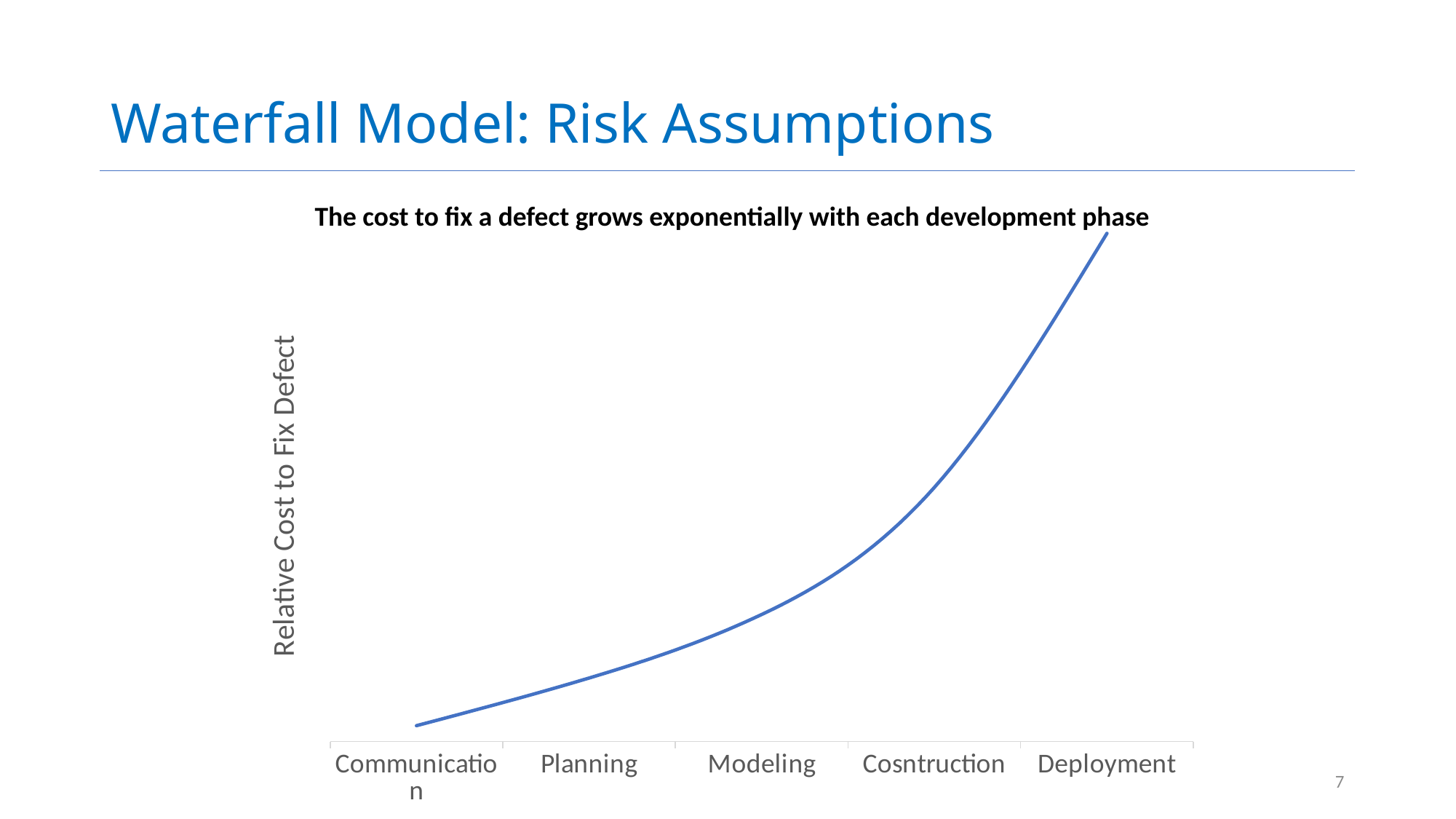
Which phase has a lower relative cost to fix a defect, Planning or Construction? Planning Which phase appears immediately after Modeling on the x axis? Cosntruction What is the title of the chart? The cost to fix a defect grows exponentially with each development phase Which development phase has the highest relative cost to fix a defect? Deployment Does the relative cost to fix a defect rise or fall from Communication to Deployment? Rises What is the label on the vertical axis of the chart? Relative Cost to Fix Defect How many development phases are shown on the x axis of the chart? 5 What kind of chart is shown on the slide? Line chart Which phase has a higher relative cost to fix a defect, Modeling or Deployment? Deployment Which development phase has the lowest relative cost to fix a defect? Communication